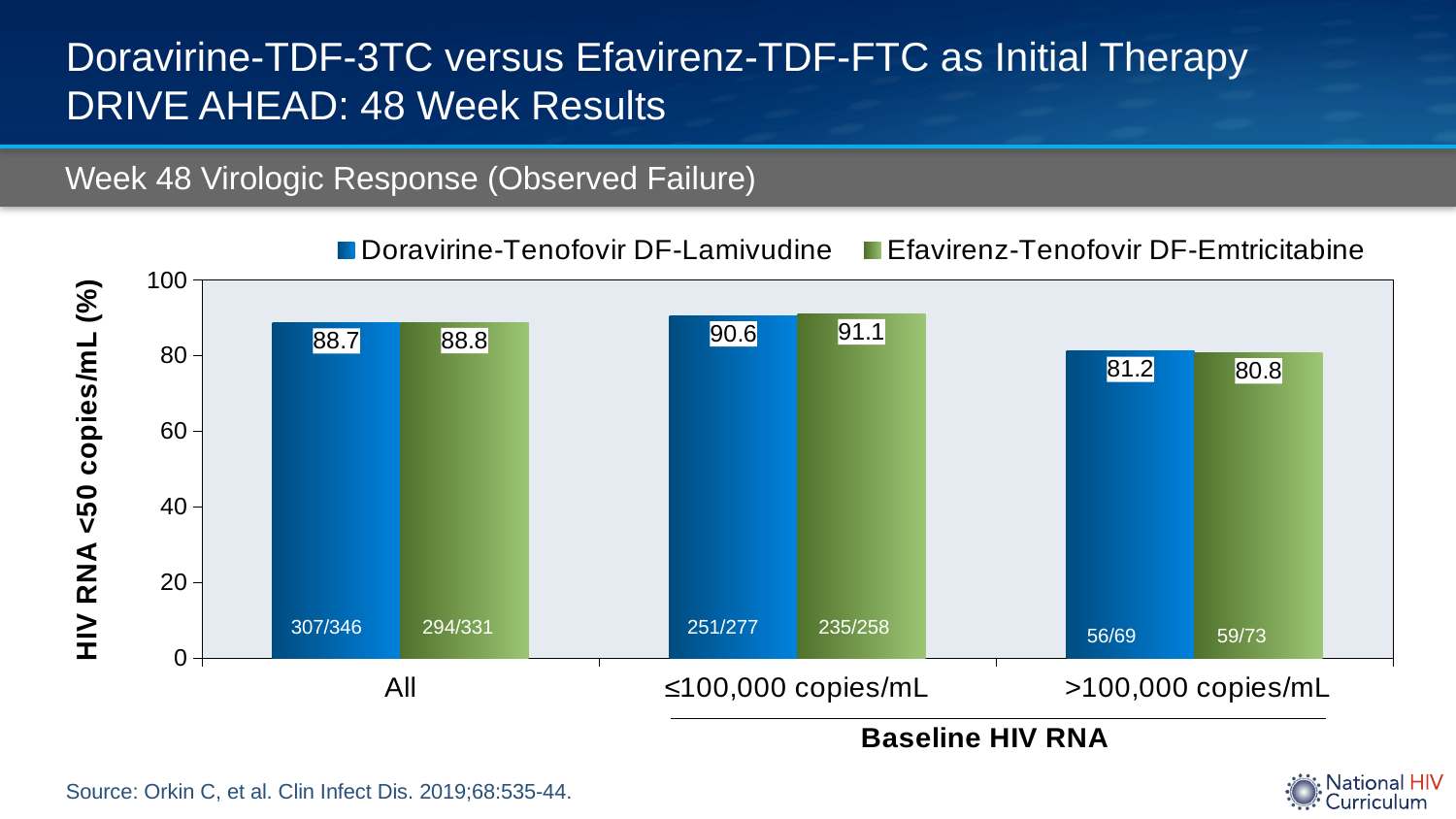
What is the percentage with HIV RNA <50 copies/mL for Doravirine-Tenofovir DF-Lamivudine in the >100,000 copies/mL group? 81.2 How many baseline HIV RNA categories are shown on the x axis? 3 What is the title of the chart? Week 48 Virologic Response (Observed Failure) What fraction of participants is shown for Efavirenz-Tenofovir DF-Emtricitabine in the >100,000 copies/mL group? 59/73 In which baseline HIV RNA category is the Doravirine-Tenofovir DF-Lamivudine response rate highest? ≤100,000 copies/mL How many series does the legend list? 2 Is the value for Efavirenz-Tenofovir DF-Emtricitabine in the All group greater or less than 80? greater What is the difference between the Doravirine-Tenofovir DF-Lamivudine response rates in the ≤100,000 copies/mL and >100,000 copies/mL groups? 9.4 What is the percentage with HIV RNA <50 copies/mL for Efavirenz-Tenofovir DF-Emtricitabine in the ≤100,000 copies/mL group? 91.1 In which baseline HIV RNA category is the Efavirenz-Tenofovir DF-Emtricitabine response rate lowest? >100,000 copies/mL What is the percentage with HIV RNA <50 copies/mL for Doravirine-Tenofovir DF-Lamivudine in the All group? 88.7 What kind of chart is shown on the slide? Bar chart